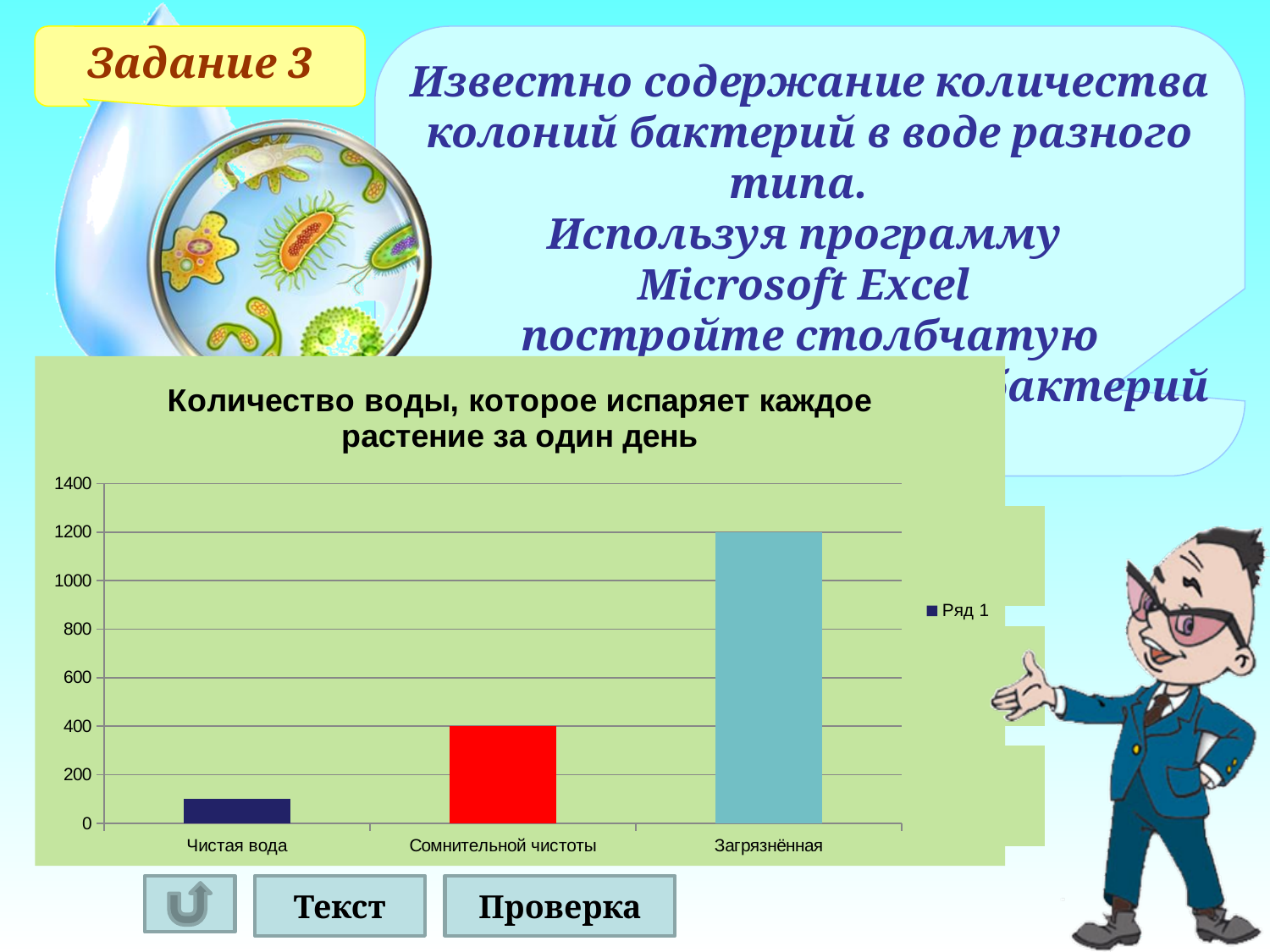
Is the value for Загрязнённая greater or less than 1000? greater How many series does the legend list? 1 What is the value for Загрязнённая? 1200 Is the value for Чистая вода greater or less than 200? less How many categories are shown on the x axis? 3 Which category has the lowest value? Чистая вода What is the difference between the values for Загрязнённая and Сомнительной чистоты? 800 What is the title of the chart? Количество воды, которое испаряет каждое растение за один день Which category has the highest value? Загрязнённая What is the value for Сомнительной чистоты? 400 What type of chart is shown on the slide? bar chart Which is larger, the value for Сомнительной чистоты or the value for Чистая вода? Сомнительной чистоты